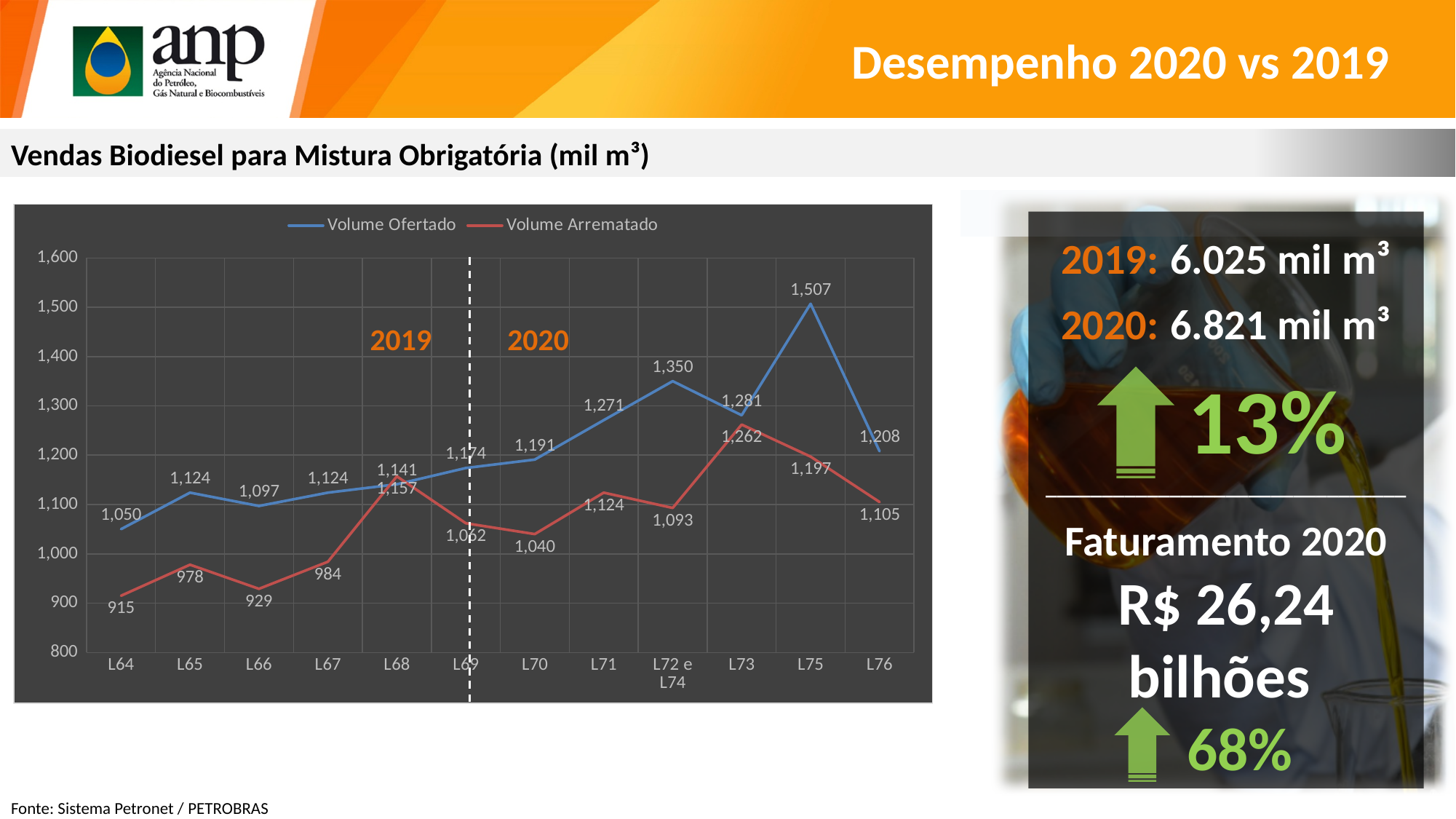
What is the difference between Volume Ofertado and Volume Arrematado at L75? 310 What is the Volume Arrematado value for L72 e L74? 1,093 Which category has the lowest Volume Arrematado? L64 Which category has the highest Volume Arrematado? L73 Which category has the highest Volume Ofertado? L75 What is the Volume Ofertado value for L75? 1,507 How many categories are shown on the x axis of the chart? 12 What kind of chart is shown on the slide? line chart How many series does the chart legend list? 2 What is the Volume Arrematado value for L64? 915 At L68, which is larger: Volume Ofertado or Volume Arrematado? Volume Arrematado Is the Volume Ofertado value for L72 e L74 greater or less than 1,300? greater